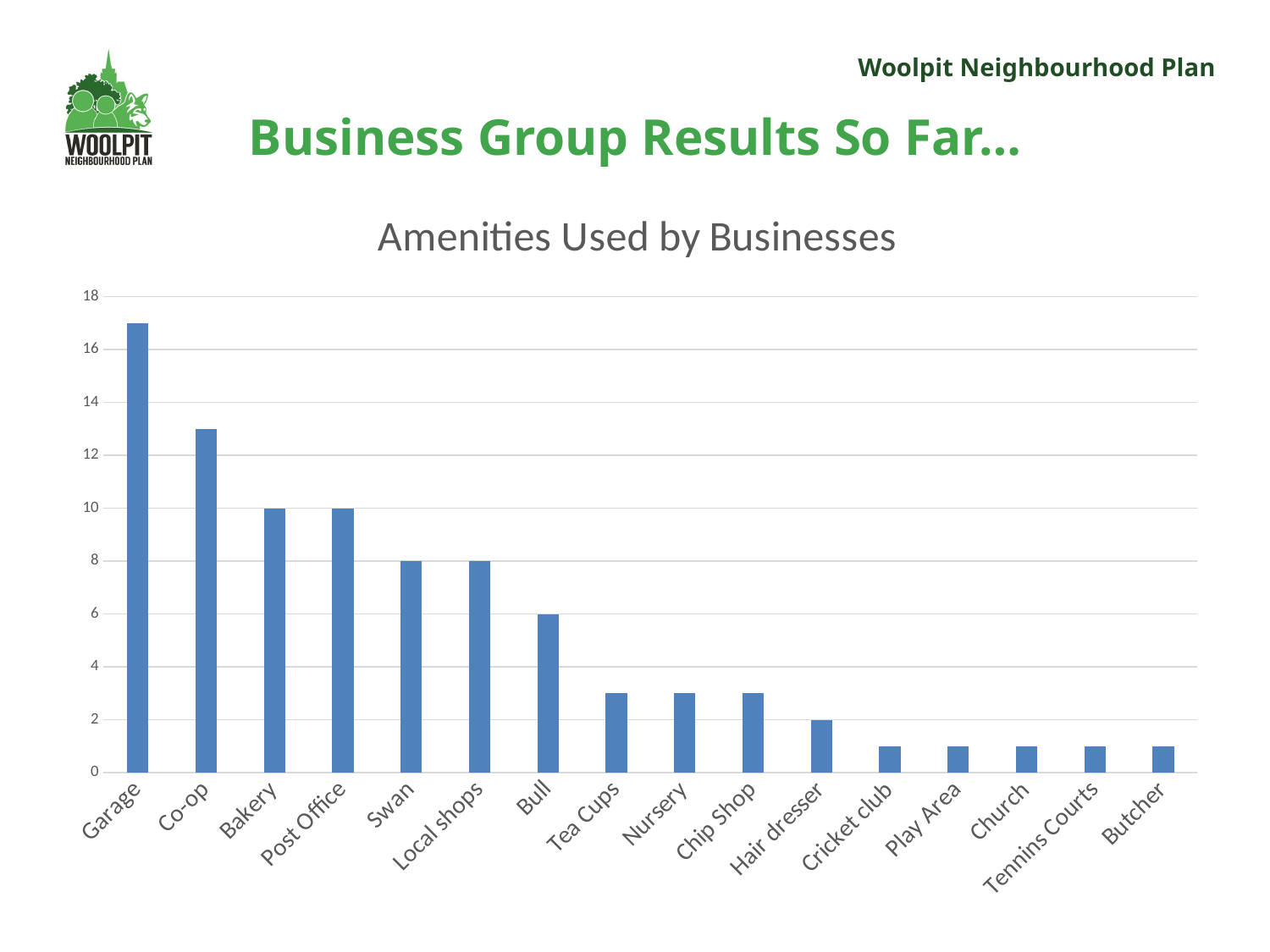
What kind of chart is shown on the slide? bar chart Which amenity has the highest value in the chart? Garage How many amenities are shown on the x axis of the chart? 16 Is the value for Garage greater or less than 16? greater Which has a larger value, Co-op or Bakery? Co-op What is the value for Bakery? 10 What is the value for Hair dresser? 2 What is the value for Swan? 8 What is the difference between the values for Post Office and Local shops? 2 What is the title of the chart? Amenities Used by Businesses Is the value for Co-op greater or less than 14? less What is the value for Bull? 6